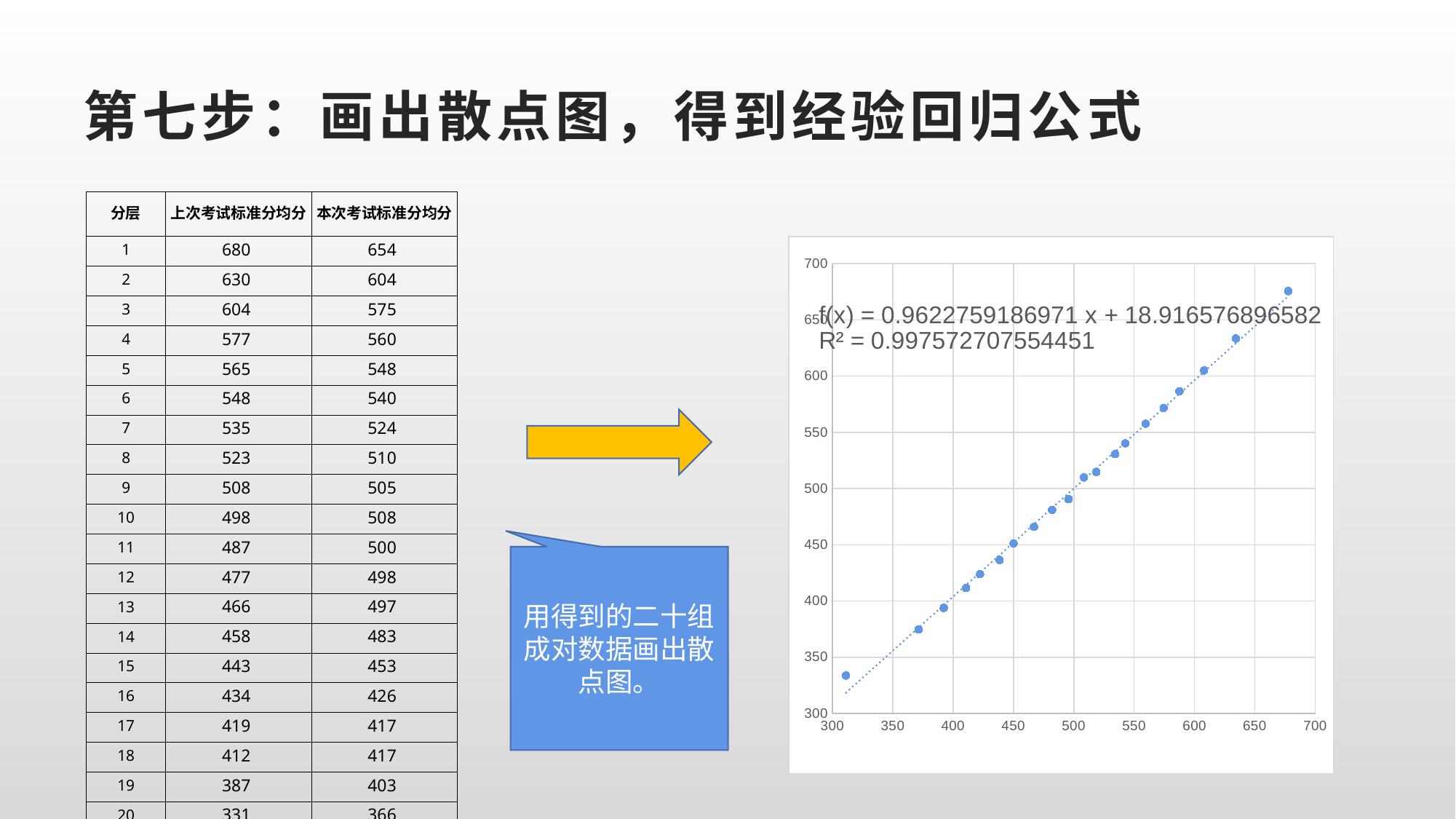
Do the plotted points rise or fall as the x value increases? Rise How many data points are plotted in the scatter chart? 20 What is the R² value shown on the scatter chart? R² = 0.997572707554451 Is the y value of the leftmost point in the scatter chart greater or less than 400? less Is the slope of the fitted trendline in the scatter chart positive or negative? Positive Is the y value of the rightmost point in the scatter chart greater or less than 600? greater What kind of chart is shown on the right of the slide? Scatter chart Which point has the highest y value in the scatter chart: the leftmost point or the rightmost point? The rightmost point Is the y value of the point plotted near x = 500 greater or less than 450? greater What is the trendline equation displayed on the scatter chart? f(x) = 0.9622759186971 x + 18.916576896582